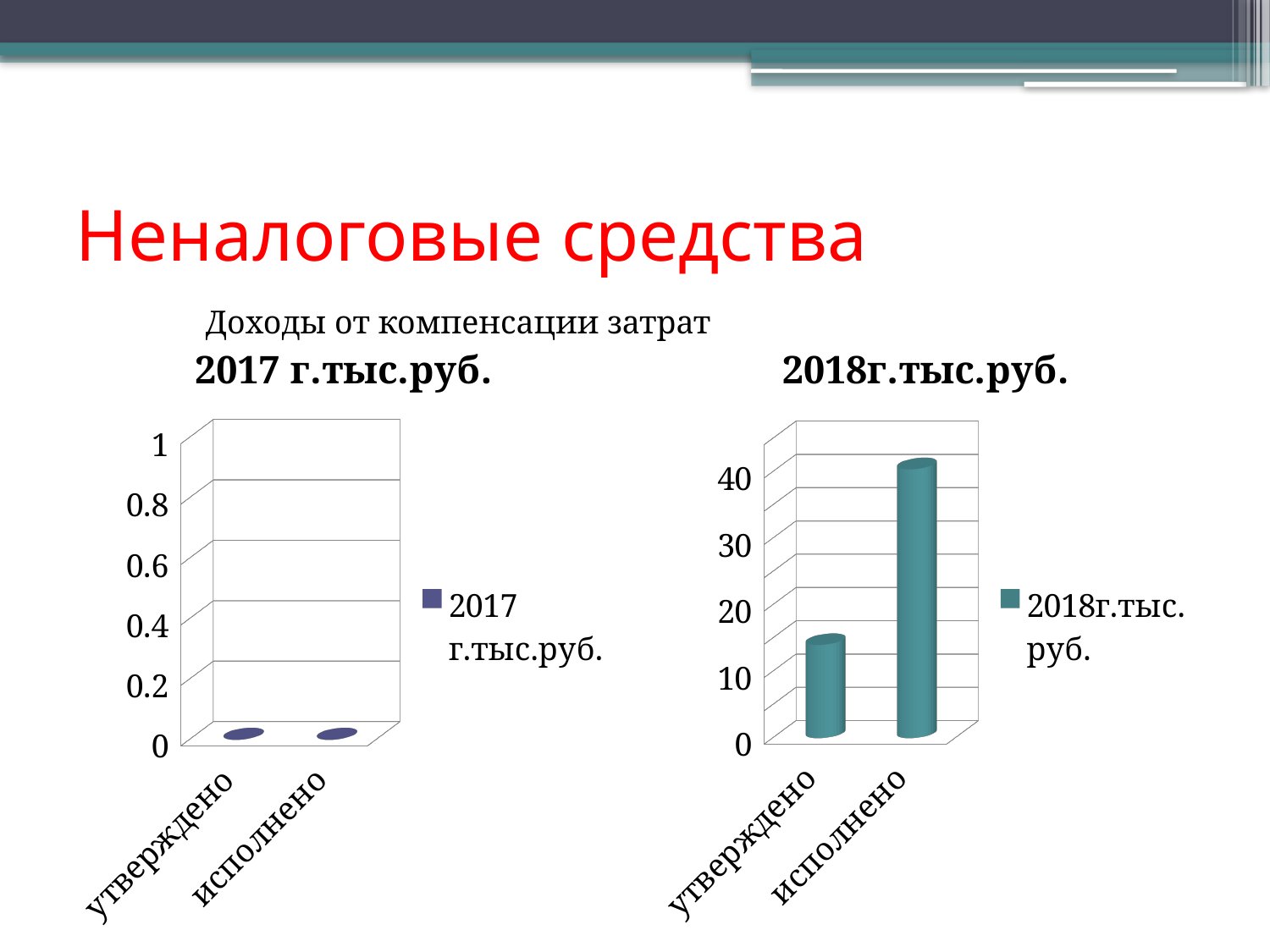
What type of chart is the "2018г.тыс.руб." chart on the right? bar chart In the "2018г.тыс.руб." chart, is the value for утверждено greater or less than 20? less In the "2018г.тыс.руб." chart, which category has the highest value? исполнено In the "2018г.тыс.руб." chart, is the value for исполнено greater or less than 30? greater In the "2018г.тыс.руб." chart, which category has the lowest value? утверждено In the "2017 г.тыс.руб." chart, what is the value for исполнено? 0 In the "2017 г.тыс.руб." chart, what is the value for утверждено? 0 In the "2018г.тыс.руб." chart, is the value for утверждено greater or less than 10? greater In the "2018г.тыс.руб." chart, which is larger: утверждено or исполнено? исполнено How many categories are shown on the x axis of the "2017 г.тыс.руб." chart? 2 How many series does the legend of the "2018г.тыс.руб." chart list? 1 What is the legend entry of the "2017 г.тыс.руб." chart on the left? 2017 г.тыс.руб.